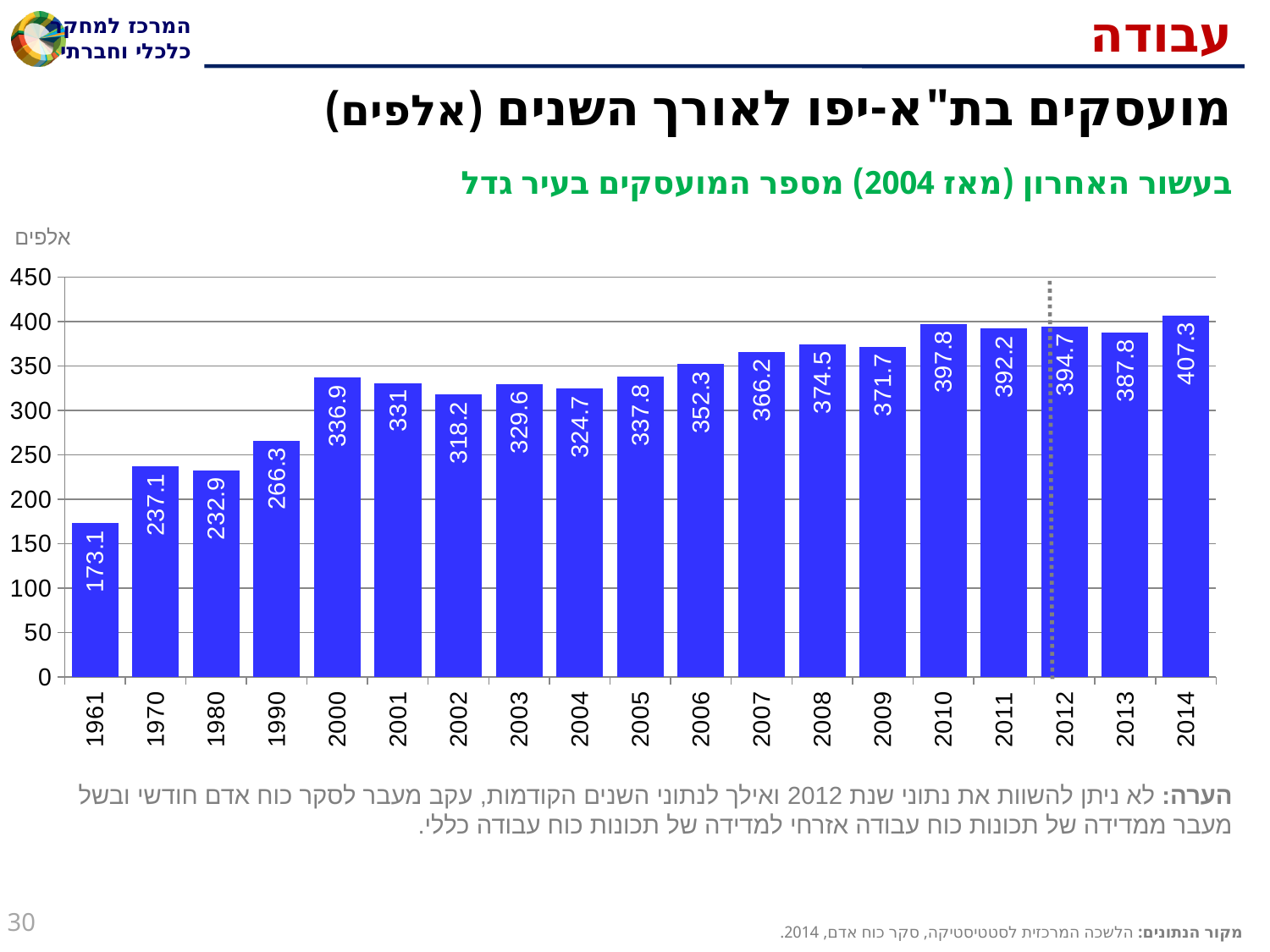
Which is larger, the value for 2010 or the value for 2011? 2010 What is the value for 1961? 173.1 Is the value for 2006 greater or less than 350? greater How many years are shown on the x axis? 19 What is the value for 2014? 407.3 What kind of chart is this? bar chart What is the difference between the values for 2000 and 1990? 70.6 What is the value for 2008? 374.5 Do the values generally rise or fall from 1961 to 2014? rise Which year has the lowest value? 1961 What is the difference between the values for 2014 and 2013? 19.5 Which year has the highest value? 2014